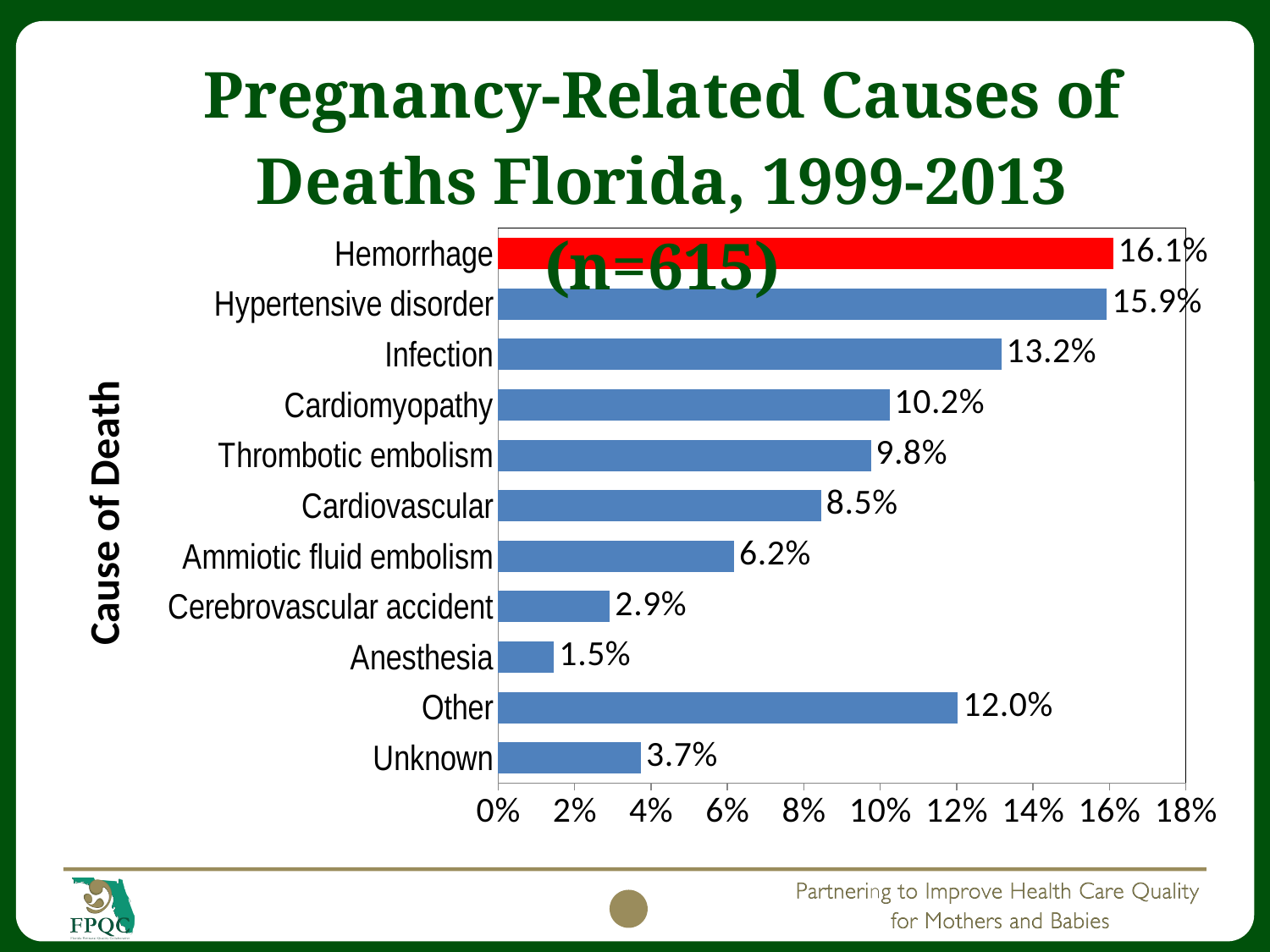
What is the label on the vertical axis of the chart? Cause of Death What kind of chart is shown on the slide? Bar chart Which is larger, the value for Other or the value for Cardiomyopathy? Other How many causes of death are listed on the chart? 11 Which cause of death has the lowest percentage? Anesthesia What is the value shown for Cardiomyopathy? 10.2% What is the difference between the percentages for Infection and Cardiovascular? 4.7% Which bar is coloured red rather than blue? Hemorrhage Which cause of death has the highest percentage? Hemorrhage Is the value for Thrombotic embolism greater or less than 8%? greater What percentage of pregnancy-related deaths is attributed to Hemorrhage? 16.1% What percentage is shown for Anesthesia? 1.5%